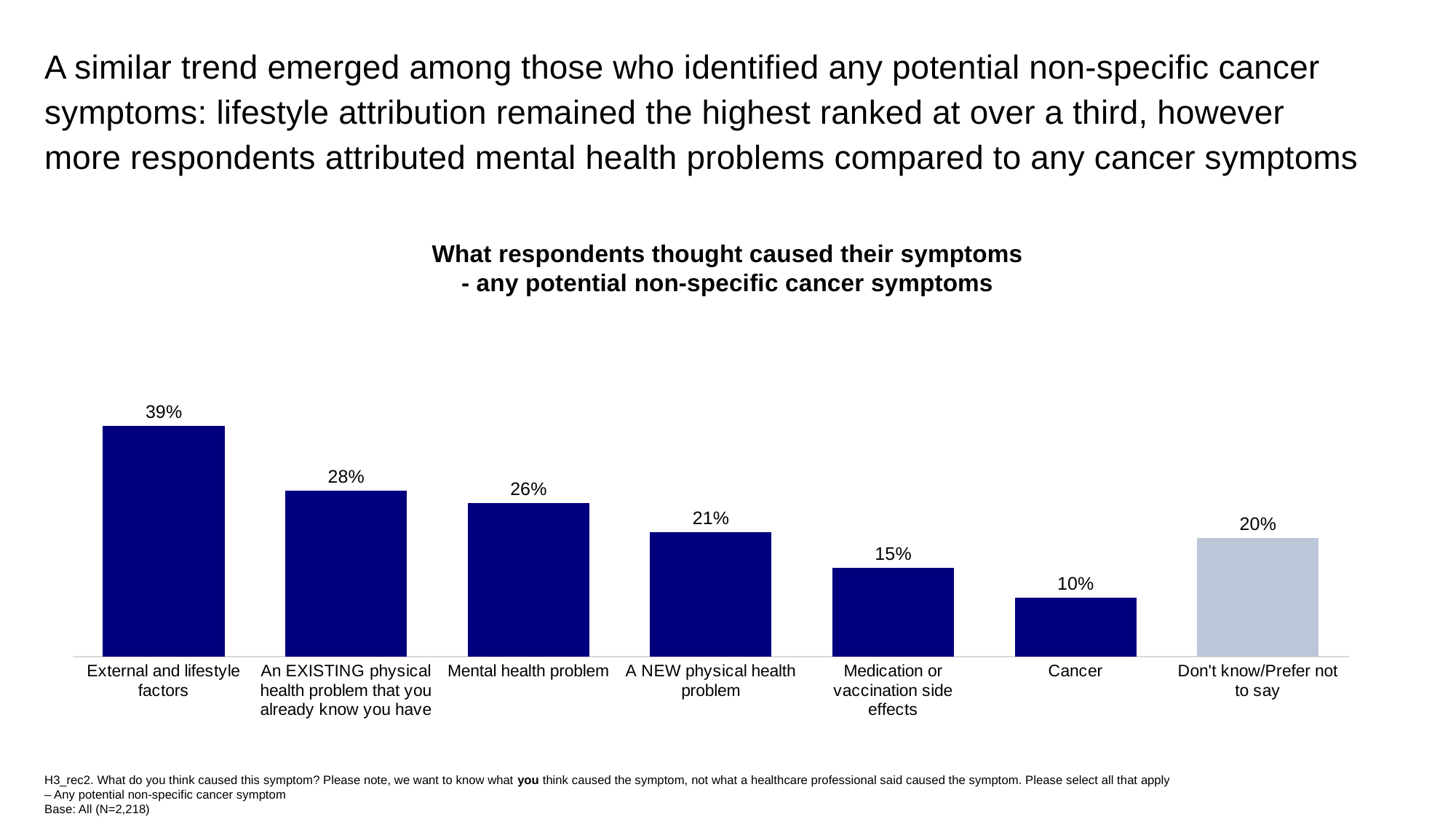
Which category has the lowest value? Cancer What is the difference between the values for 'External and lifestyle factors' and 'Cancer'? 29% What percentage of respondents attributed their symptoms to cancer? 10% How many categories are shown in the chart? 7 What percentage of respondents attributed their symptoms to external and lifestyle factors? 39% Which category has the highest value? External and lifestyle factors What is the value for 'Mental health problem'? 26% What type of chart is shown on the slide? Bar chart Which bar is shown in a different (lighter) colour from the others? Don't know/Prefer not to say Which is larger: the value for 'Medication or vaccination side effects' or the value for 'Don't know/Prefer not to say'? Don't know/Prefer not to say What is the difference between 'An EXISTING physical health problem that you already know you have' and 'A NEW physical health problem'? 7% What is the value for 'Don't know/Prefer not to say'? 20%